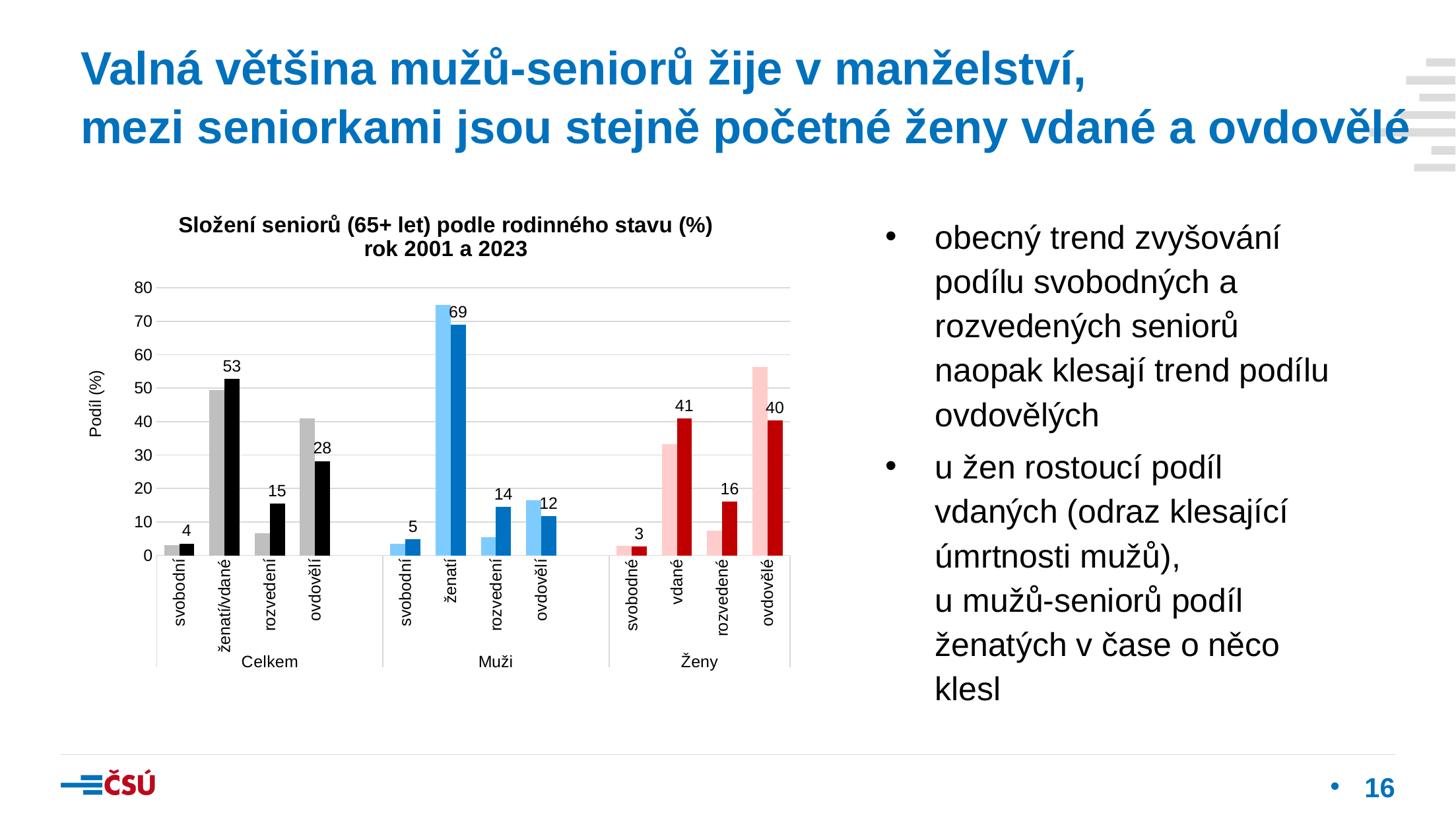
What is the difference between the labelled values for ženatí/vdané and ovdovělí in the Celkem group? 25 What kind of chart is shown on the slide? bar chart Which labelled bar has the lowest value in the chart? svobodné (Ženy), 3 What value is labelled on the ovdovělé bar in the Ženy group? 40 What value is labelled on the rozvedení bar in the Celkem group? 15 Which is larger: the labelled value for ovdovělí in the Celkem group or the labelled value for ovdovělí in the Muži group? ovdovělí in the Celkem group (28) What value is labelled on the ženatí bar in the Muži group? 69 What is the difference between the labelled values for ženatí and rozvedení in the Muži group? 55 How many marital-status categories are shown on the x axis across all three groups? 12 Is the value of the lighter (unlabelled) ženatí bar in the Muži group greater or less than 70? greater What is the title of the chart? Složení seniorů (65+ let) podle rodinného stavu (%) rok 2001 a 2023 Which labelled bar has the highest value in the chart? ženatí (Muži), 69